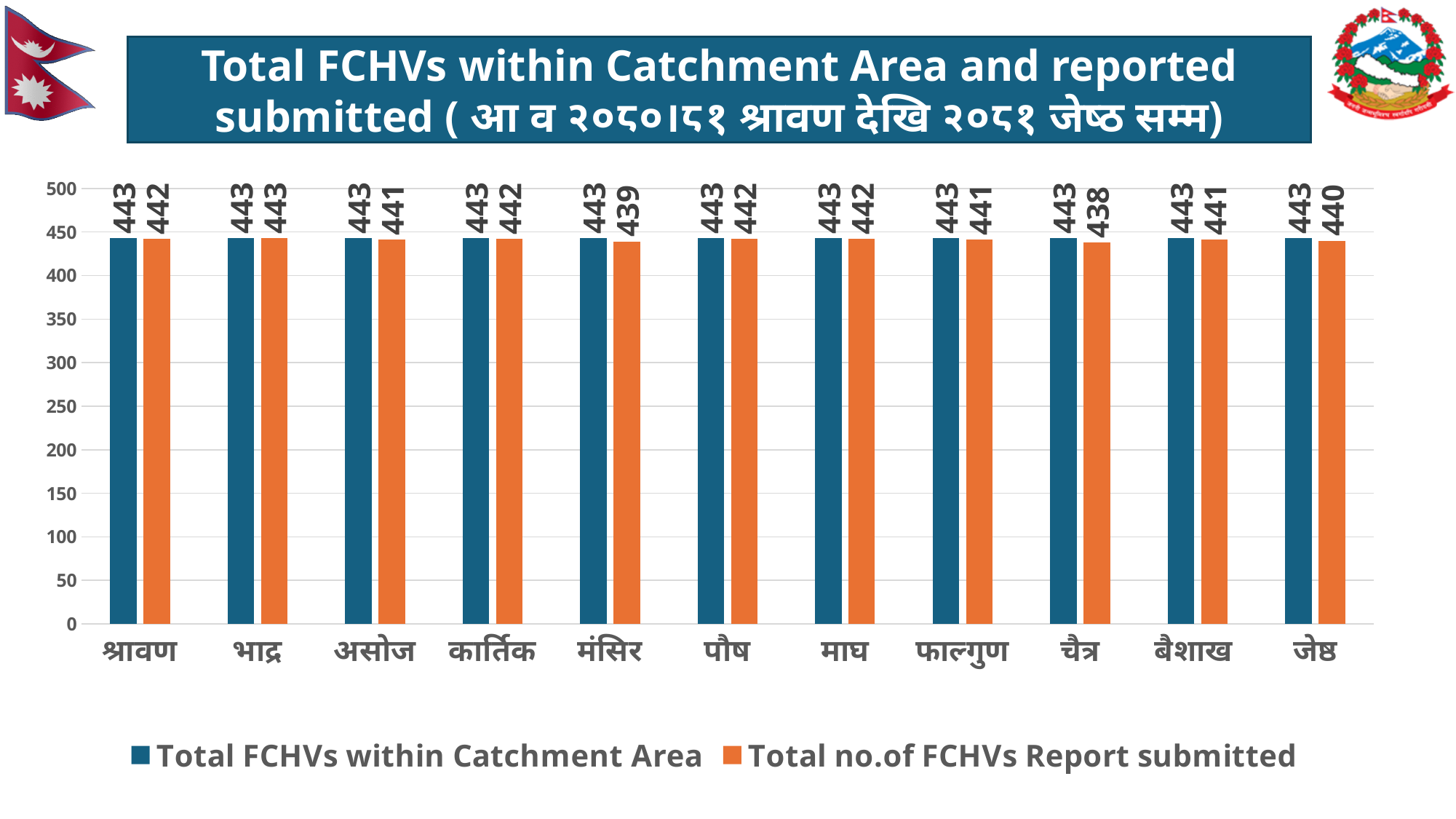
How many series does the legend list? 2 What kind of chart is shown on the slide? Bar chart What is the difference between Total FCHVs within Catchment Area and Total no.of FCHVs Report submitted for श्रावण? 1 What is the value of Total no.of FCHVs Report submitted for जेष्ठ? 440 Which is larger for मंसिर: Total FCHVs within Catchment Area or Total no.of FCHVs Report submitted? Total FCHVs within Catchment Area How many months are shown on the x axis of the chart? 11 What is the value of Total FCHVs within Catchment Area for श्रावण? 443 What is the difference between Total FCHVs within Catchment Area and Total no.of FCHVs Report submitted for चैत्र? 5 What is the value of Total no.of FCHVs Report submitted for मंसिर? 439 What is the value of Total no.of FCHVs Report submitted for चैत्र? 438 In which month is the Total no.of FCHVs Report submitted the lowest? चैत्र In which month is the Total no.of FCHVs Report submitted the highest? भाद्र